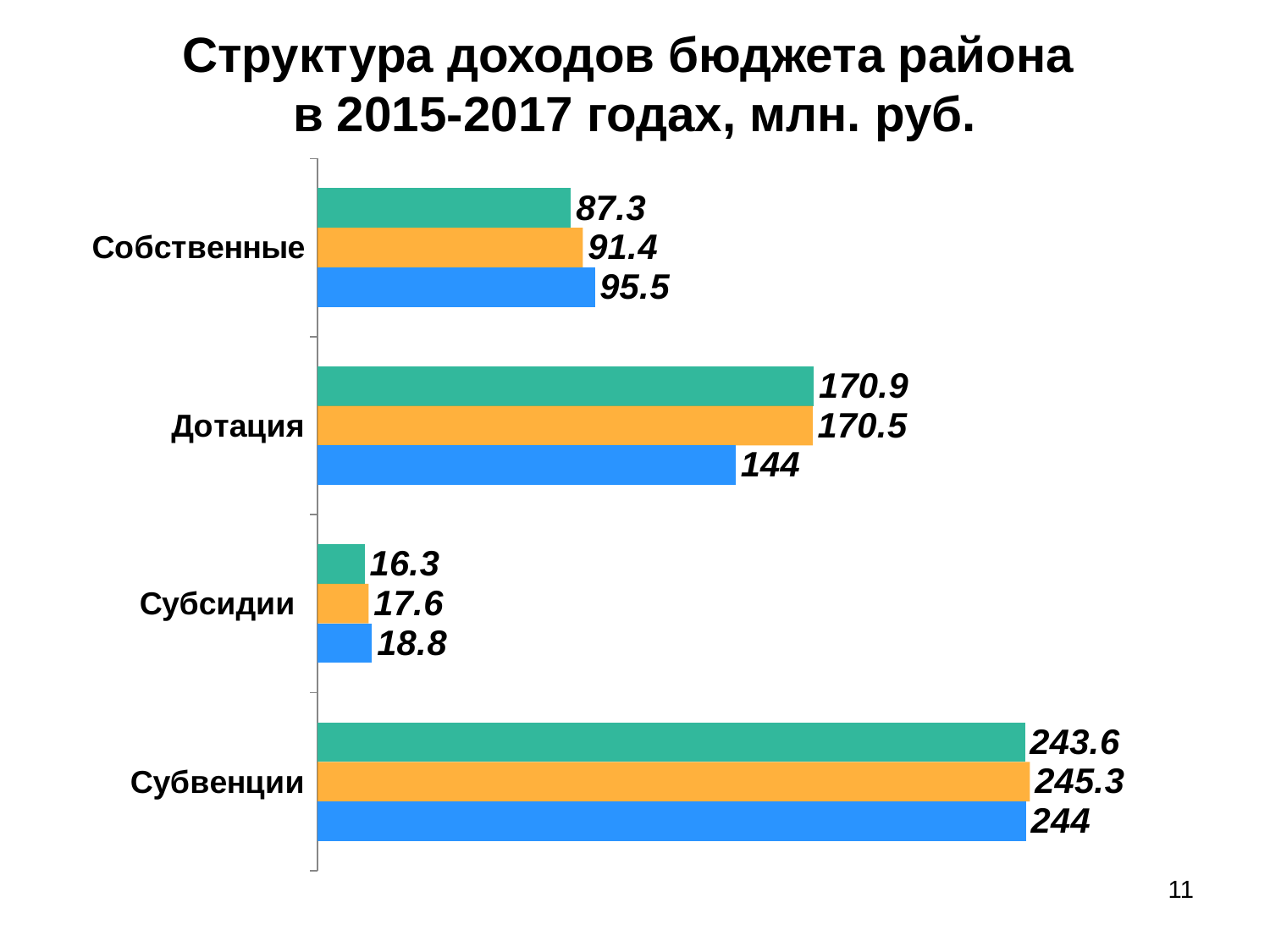
Which category has the highest values overall? Субвенции How many categories are shown on the chart? 4 What is the value of the green bar for Дотация? 170.9 Which category has the lowest values overall? Субсидии What type of chart is shown on the slide? bar chart What is the difference between the green bar (170.9) and the blue bar (144) for Дотация? 26.9 What is the value of the orange bar for Субвенции? 245.3 For Субсидии, which is larger: the blue bar or the green bar? the blue bar What is the value of the blue bar for Собственные? 95.5 What is the title of the chart? Структура доходов бюджета района в 2015-2017 годах, млн. руб. What is the difference between the blue bar (95.5) and the green bar (87.3) for Собственные? 8.2 What is the value of the green bar for Субсидии? 16.3